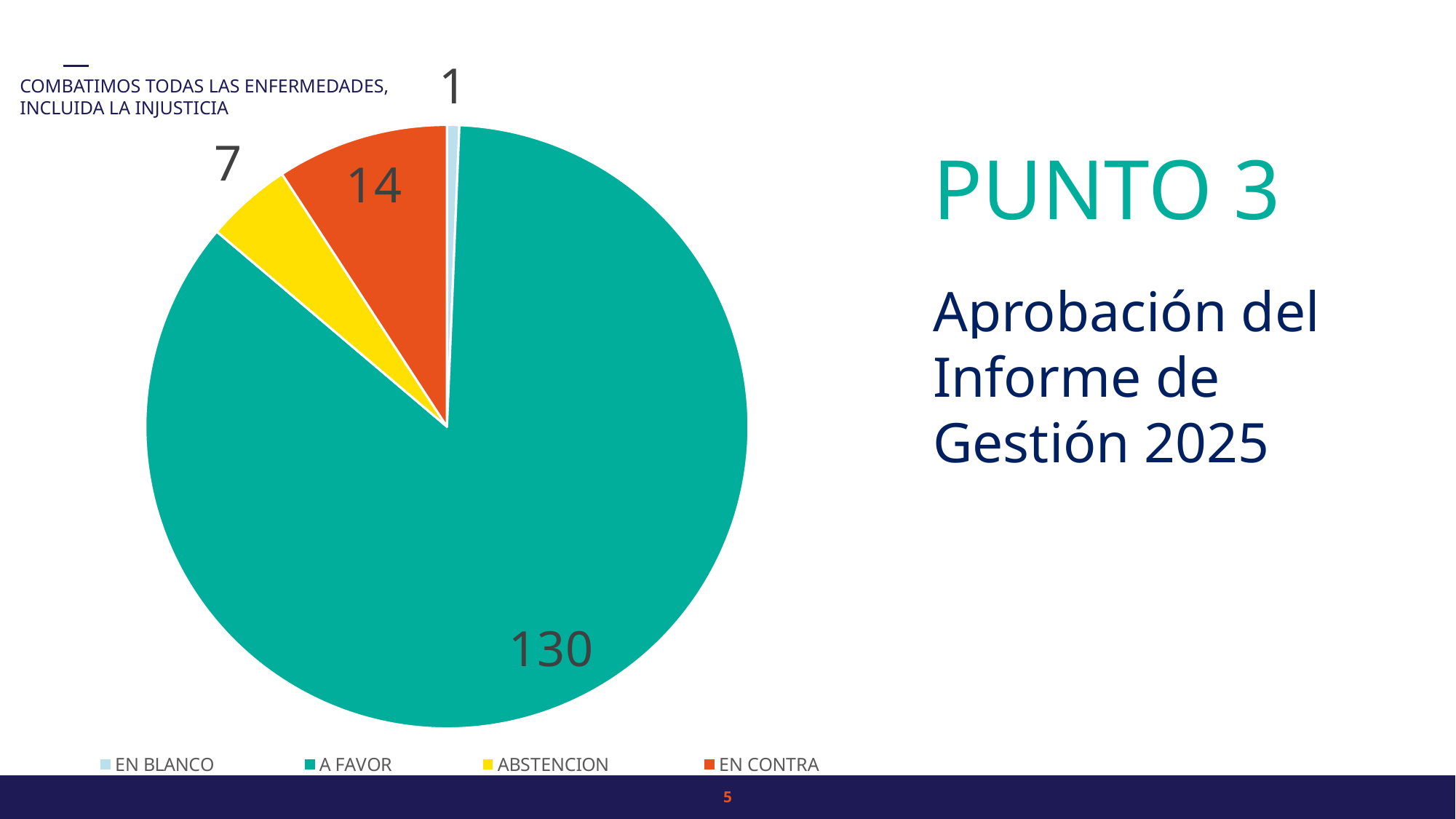
What is the value for EN CONTRA? 14 Which category has the smallest slice of the pie? EN BLANCO What is the difference between the A FAVOR and EN CONTRA values? 116 What is the total of all the values in the pie chart? 152 What type of chart is shown on the slide? pie chart Which category has the largest slice of the pie? A FAVOR What is the value for EN BLANCO? 1 What is the value for ABSTENCION? 7 Which is larger, EN CONTRA or ABSTENCION? EN CONTRA How many categories does the pie chart have? 4 Which colour represents ABSTENCION in the legend? yellow How many votes are shown for A FAVOR? 130